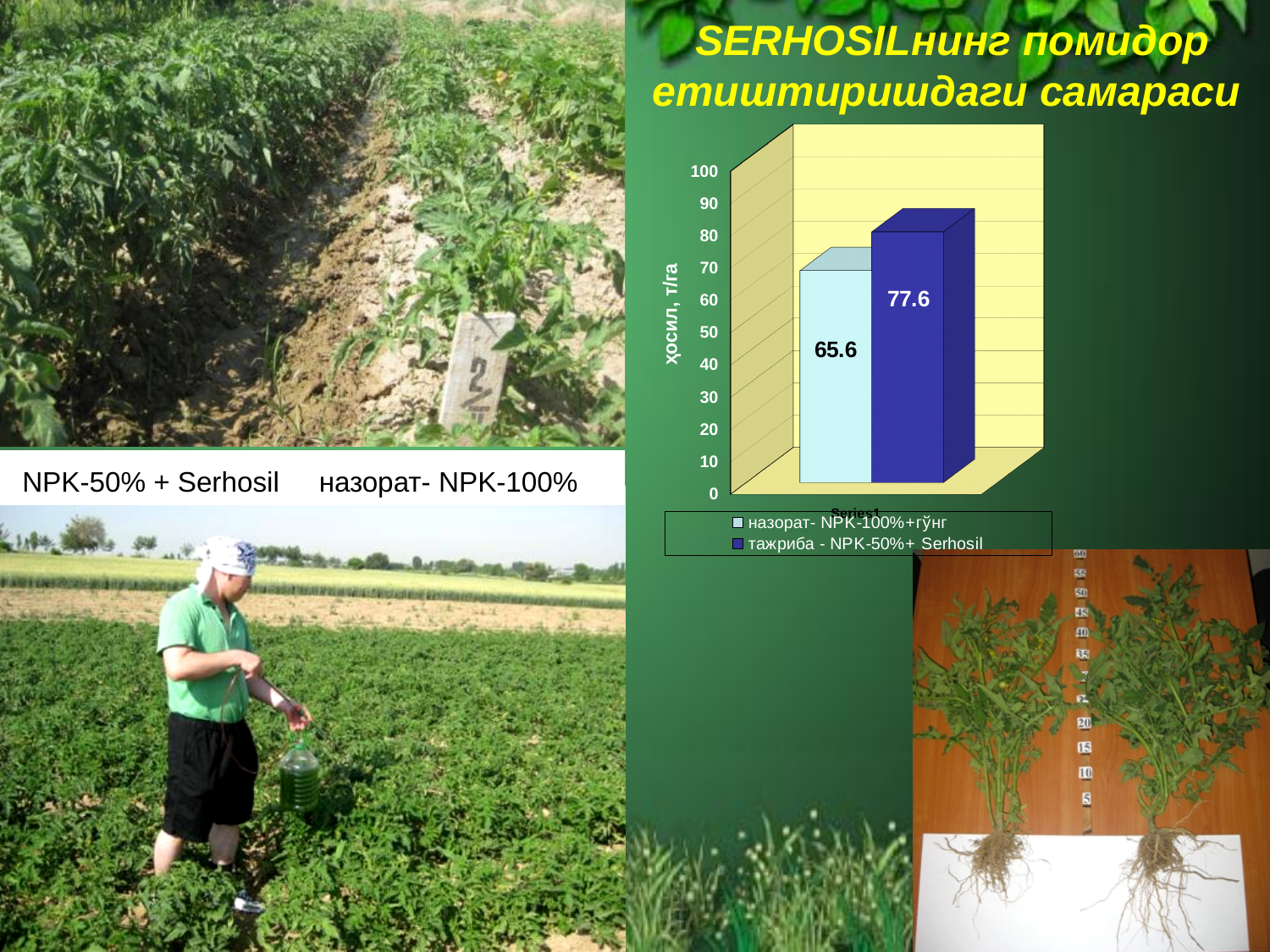
Is the value for назорат- NPK-100%+гўнг greater or less than 70? less How many series does the legend list? 2 Which series has the higher value? тажриба - NPK-50%+ Serhosil What is the difference between the values for тажриба - NPK-50%+ Serhosil and назорат- NPK-100%+гўнг? 12 Is the value for назорат- NPK-100%+гўнг larger or smaller than the value for тажриба - NPK-50%+ Serhosil? smaller What kind of chart is shown on the slide? bar chart What is the value for тажриба - NPK-50%+ Serhosil? 77.6 How many bars are plotted in the chart? 2 What is the value for назорат- NPK-100%+гўнг? 65.6 Is the value for тажриба - NPK-50%+ Serhosil greater or less than 70? greater What is the label of the vertical axis? ҳосил, т/га Which series has the lower value? назорат- NPK-100%+гўнг